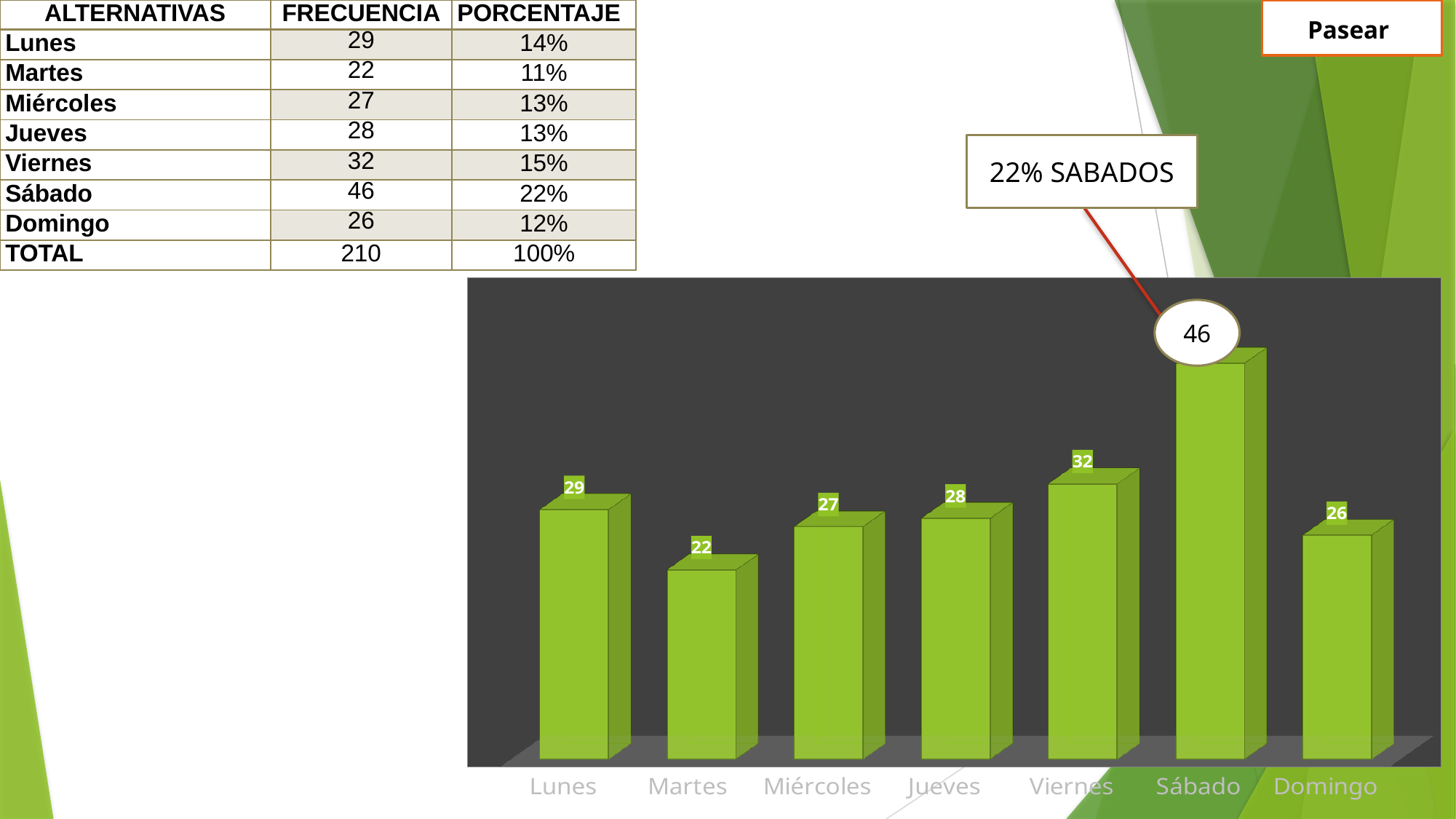
Which day has the lowest bar? Martes What is the difference between the values for Sábado and Lunes? 17 Which day has the highest bar? Sábado What is the difference between the values for Viernes and Martes? 10 What is the value of the bar for Martes? 22 Which is larger, the value for Lunes or the value for Domingo? Lunes What kind of chart is shown on the slide? bar chart How many bars are shown in the chart? 7 Which is larger, the value for Jueves or the value for Miércoles? Jueves What is the value of the bar for Viernes? 32 What percentage does the callout on the chart give for Sábado? 22% What is the value of the bar for Domingo? 26